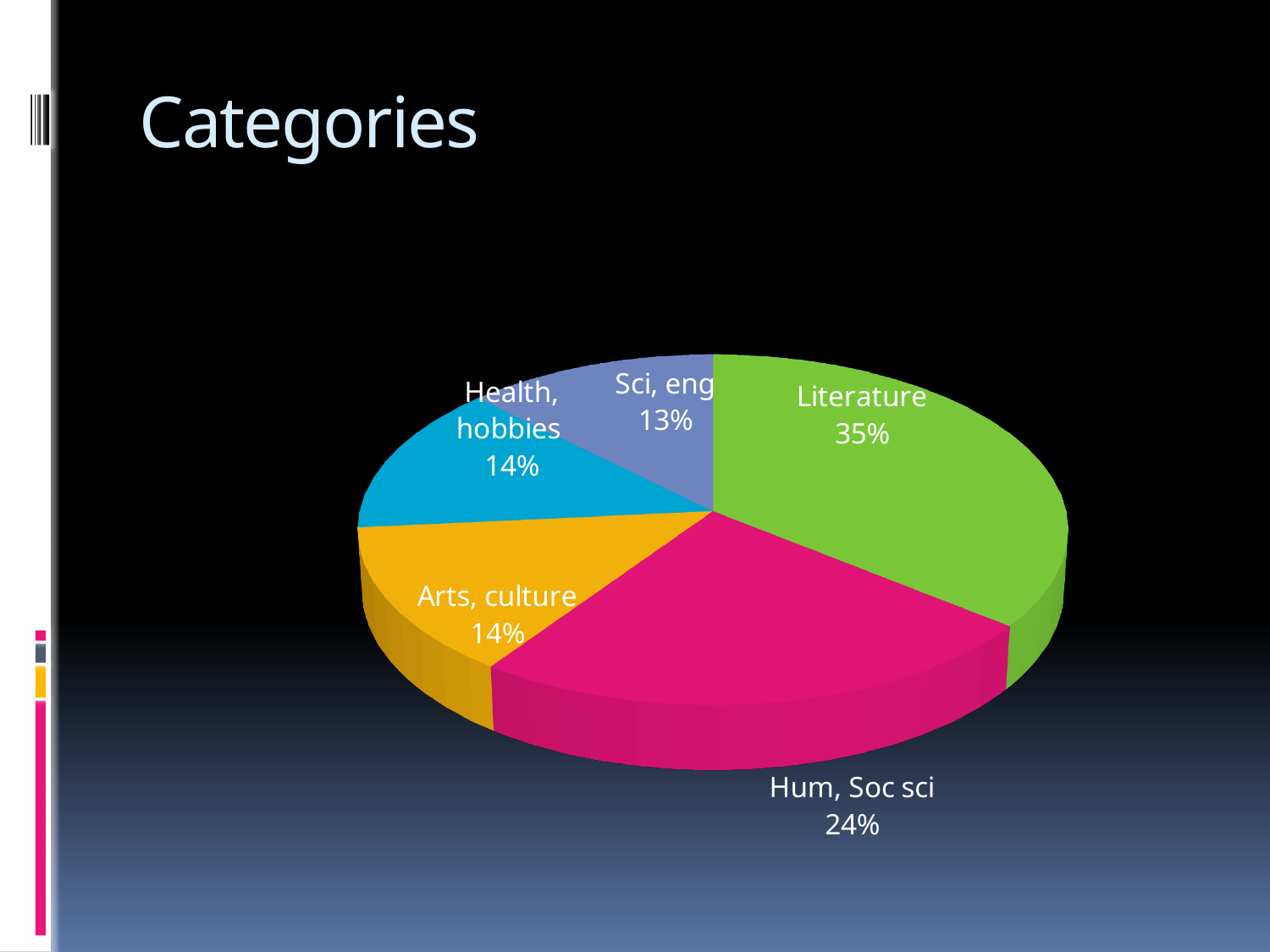
What share of the pie does Hum, Soc sci have? 24% What is the title of the slide containing the pie chart? Categories Which is larger, the share for Hum, Soc sci or the share for Arts, culture? Hum, Soc sci What share of the pie does Health, hobbies have? 14% Which category has the largest slice of the pie? Literature What kind of chart is shown on the slide? pie chart What is the difference in percentage points between Literature and Hum, Soc sci? 11 Which category has the smallest slice of the pie? Sci, eng What share of the pie does Arts, culture have? 14% How many categories are shown in the pie chart? 5